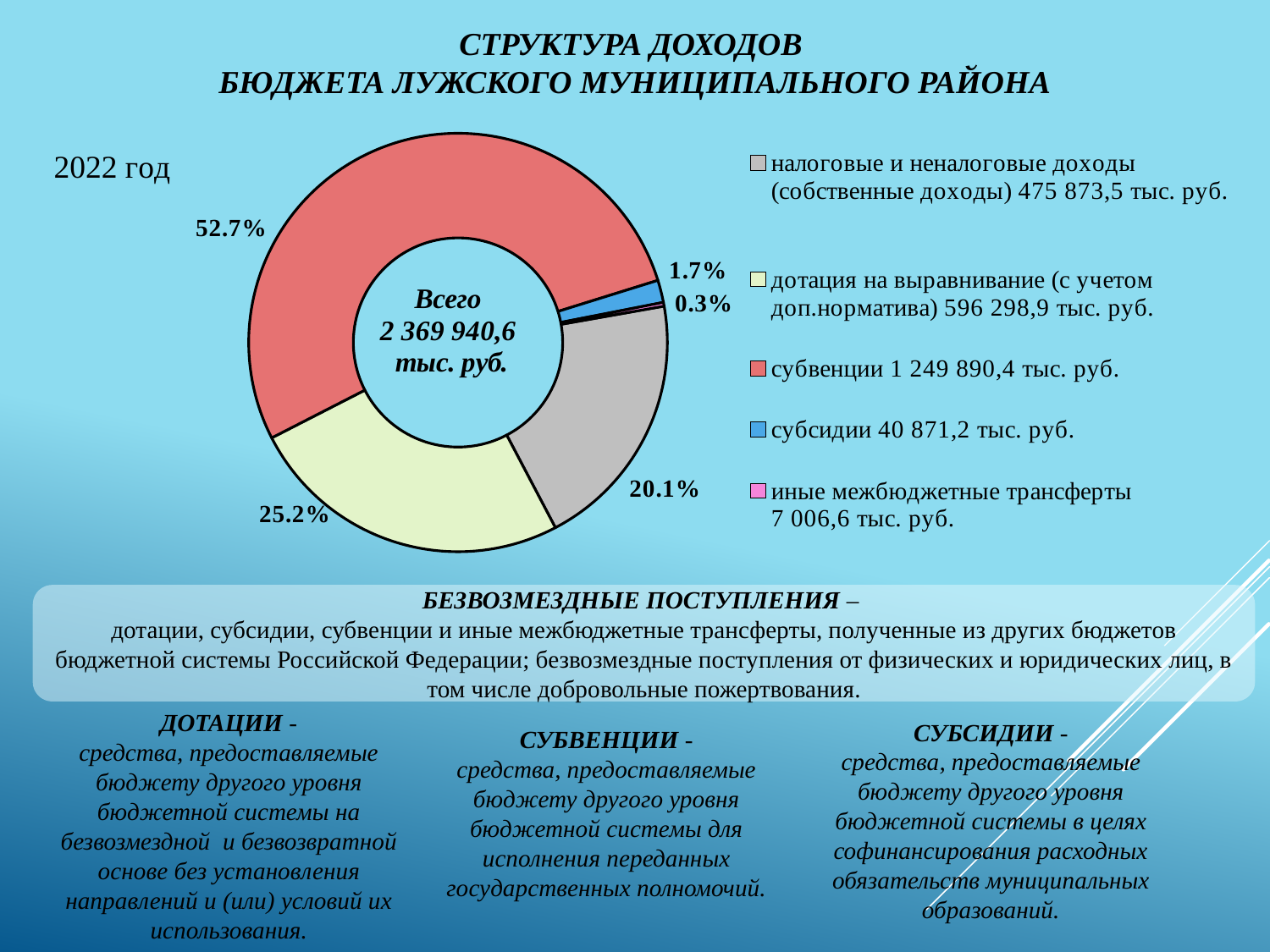
What kind of chart is shown on the slide? Pie (donut) chart What is the total shown in the centre of the donut chart? 2 369 940,6 тыс. руб. Which category has the largest slice of the pie? субвенции Which category has the smallest slice of the pie? иные межбюджетные трансферты What share of the pie do налоговые и неналоговые доходы (собственные доходы) take? 20.1% What share of the pie does субвенции take? 52.7% What share of the pie do субсидии take? 1.7% What is the value for субсидии shown in the legend? 40 871,2 тыс. руб. How many categories does the legend list? 5 What is the difference in percentage points between the субвенции slice and the дотация на выравнивание slice? 27.5